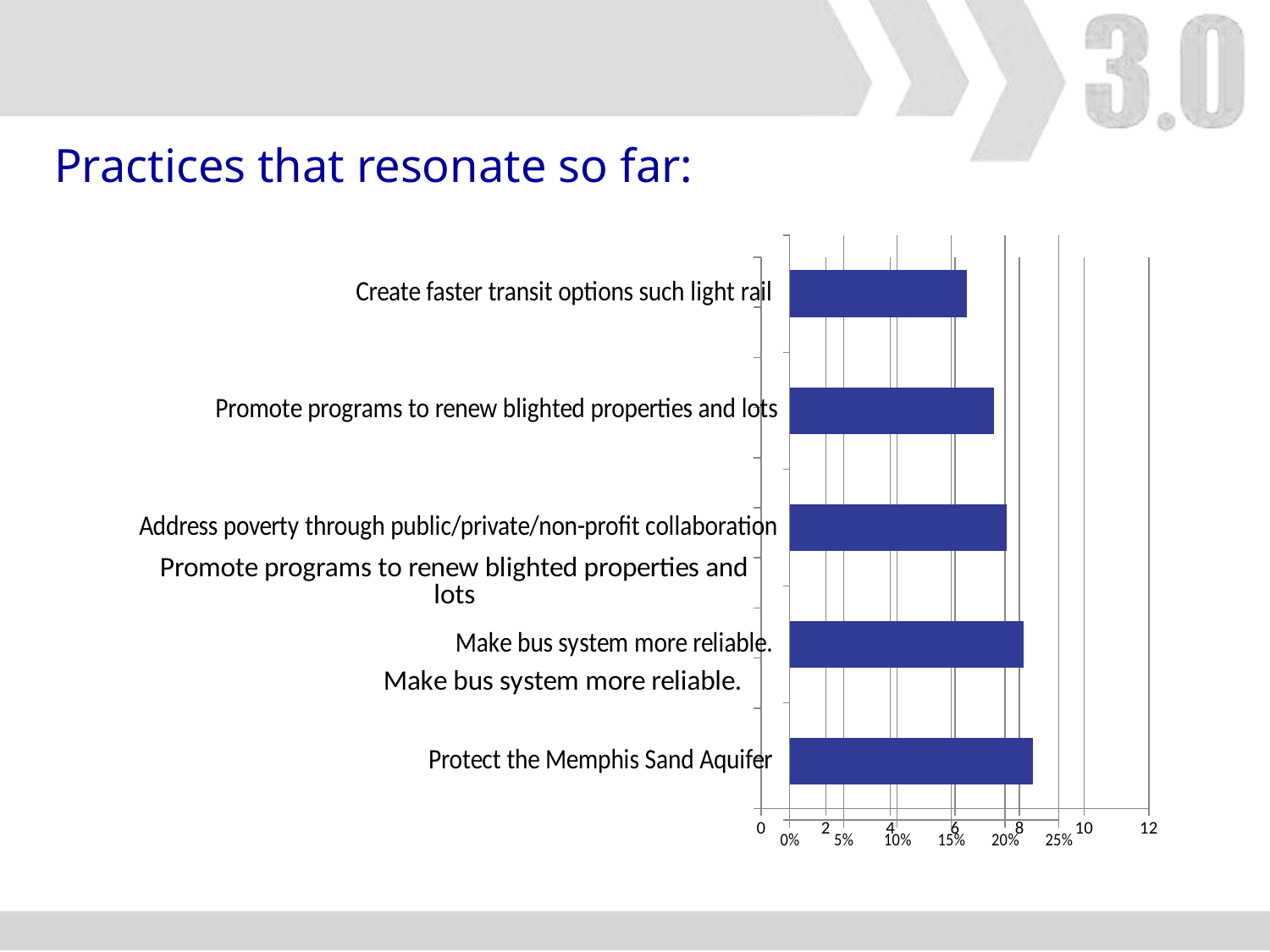
Which category has the longest bar? Protect the Memphis Sand Aquifer Do the bars get longer or shorter going from the top category to the bottom category? longer Is the value for 'Make bus system more reliable.' greater or less than 20%? greater Which is larger: the value for 'Create faster transit options such light rail' or the value for 'Protect the Memphis Sand Aquifer'? Protect the Memphis Sand Aquifer Which is larger: the value for 'Promote programs to renew blighted properties and lots' or the value for 'Make bus system more reliable.'? Make bus system more reliable. Is the value for 'Create faster transit options such light rail' greater or less than 15%? greater How many categories (bars) does the chart show? 5 What is the title of the slide containing the chart? Practices that resonate so far: What kind of chart is shown on the slide? bar chart Which category has the shortest bar? Create faster transit options such light rail Is the value for 'Create faster transit options such light rail' greater or less than 20%? less